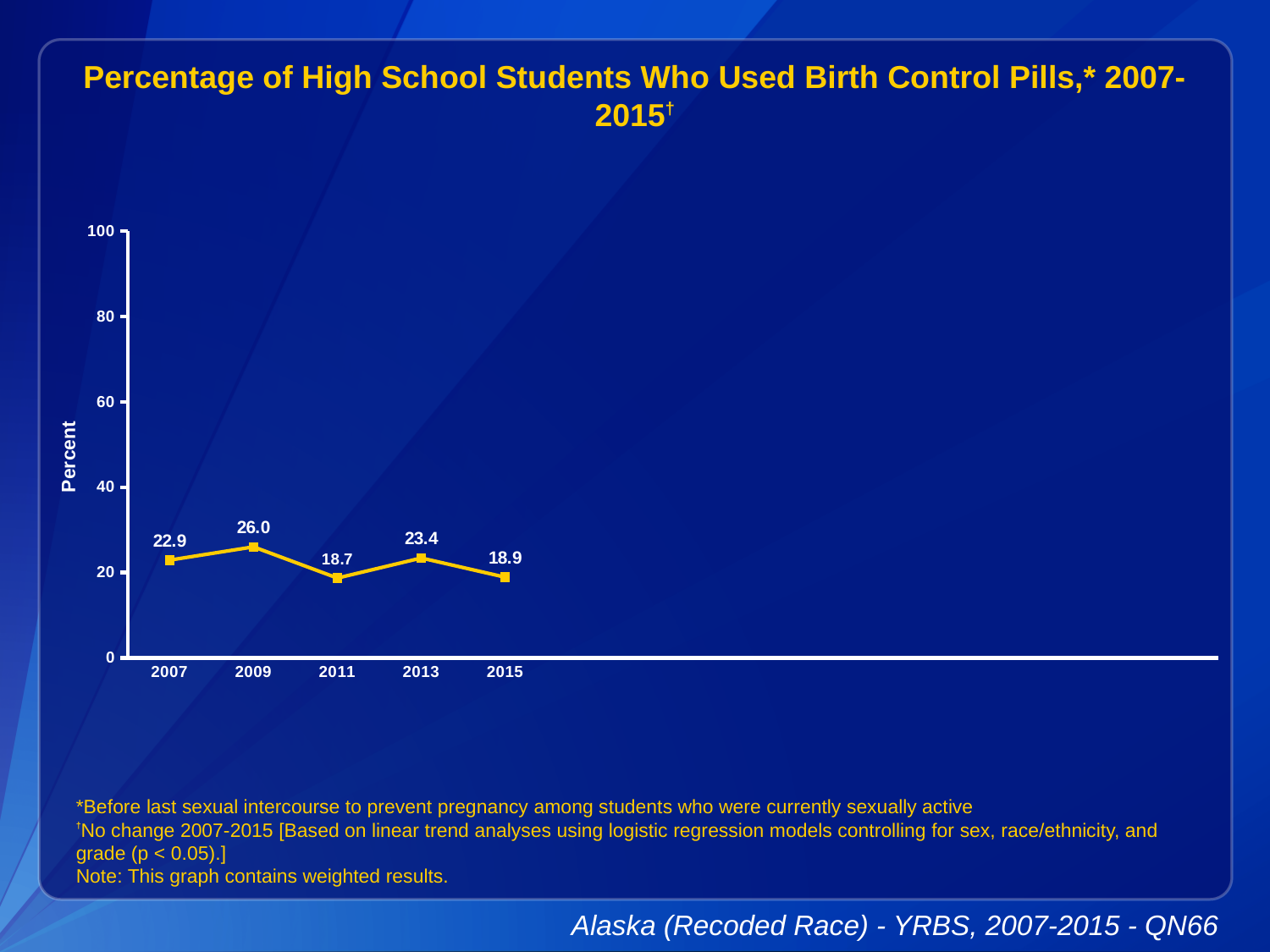
Does the value rise or fall from 2013 to 2015? fall What is the value plotted for 2011? 18.7 What kind of chart is shown on the slide? line chart Is the value for 2009 greater or less than 40? less What percentage of high school students used birth control pills in 2007? 22.9 How many years are plotted on the chart? 5 Which year has a larger value, 2007 or 2013? 2013 What is the label on the y axis? Percent Which year has the highest percentage? 2009 Which year has the lowest percentage? 2011 What is the value plotted for 2015? 18.9 What is the difference between the 2009 value and the 2011 value? 7.3